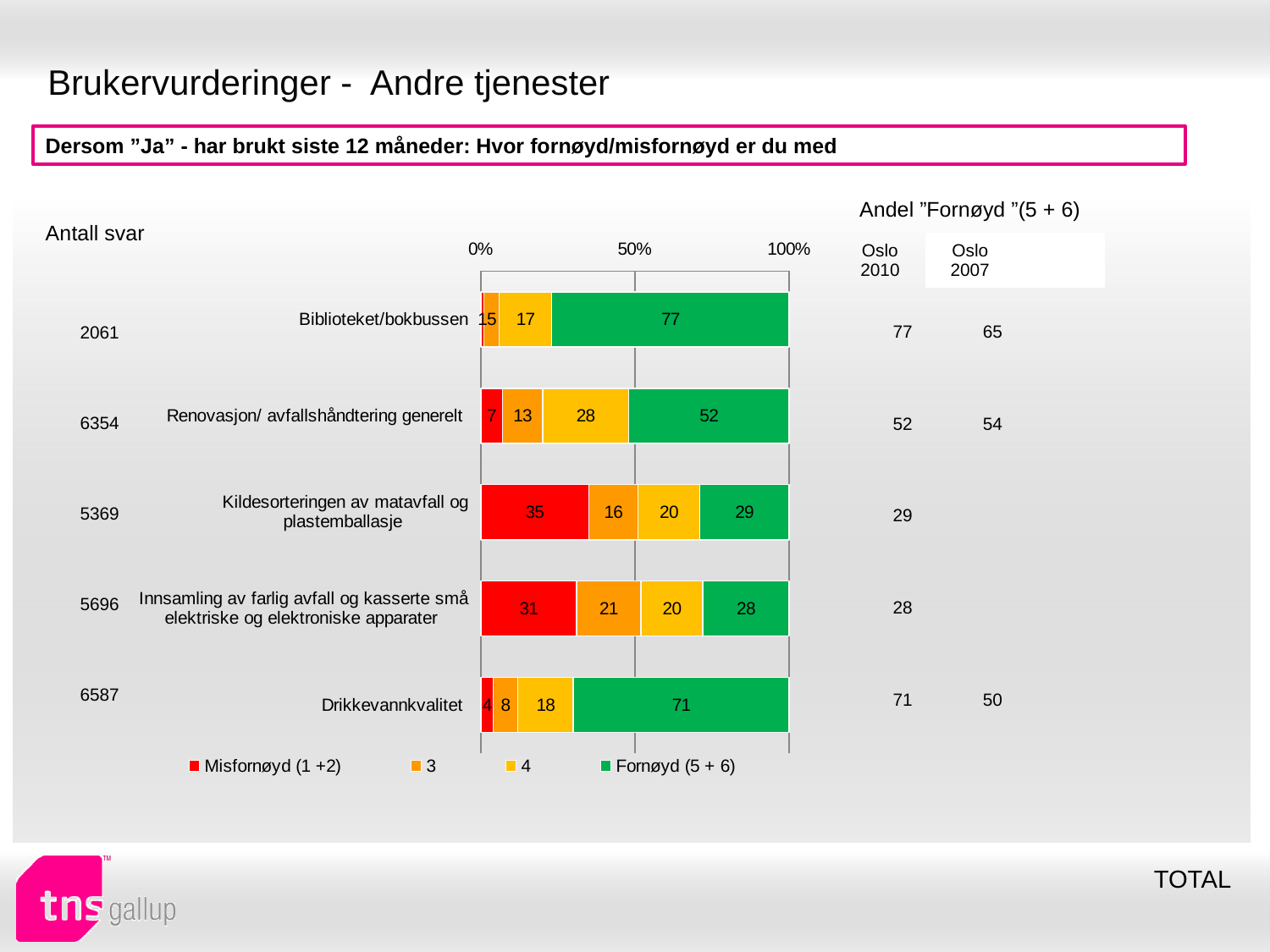
What is the value of series 3 for Innsamling av farlig avfall og kasserte små elektriske og elektroniske apparater? 21 What is the value of series 4 for Drikkevannkvalitet? 18 How many series does the chart legend list? 4 How many categories (services) are plotted in the chart? 5 What is the total of the stacked bar for Renovasjon/ avfallshåndtering generelt? 100 What is the difference between the Fornøyd (5 + 6) values for Drikkevannkvalitet and Renovasjon/ avfallshåndtering generelt? 19 What is the Misfornøyd (1 +2) value for Kildesorteringen av matavfall og plastemballasje? 35 What kind of chart is shown on the slide? stacked bar chart What is the Fornøyd (5 + 6) value for Biblioteket/bokbussen? 77 Which category has the lowest Fornøyd (5 + 6) value? Innsamling av farlig avfall og kasserte små elektriske og elektroniske apparater Which is larger: the Misfornøyd (1 +2) value for Kildesorteringen av matavfall og plastemballasje or for Innsamling av farlig avfall og kasserte små elektriske og elektroniske apparater? Kildesorteringen av matavfall og plastemballasje Which category has the highest Fornøyd (5 + 6) value? Biblioteket/bokbussen